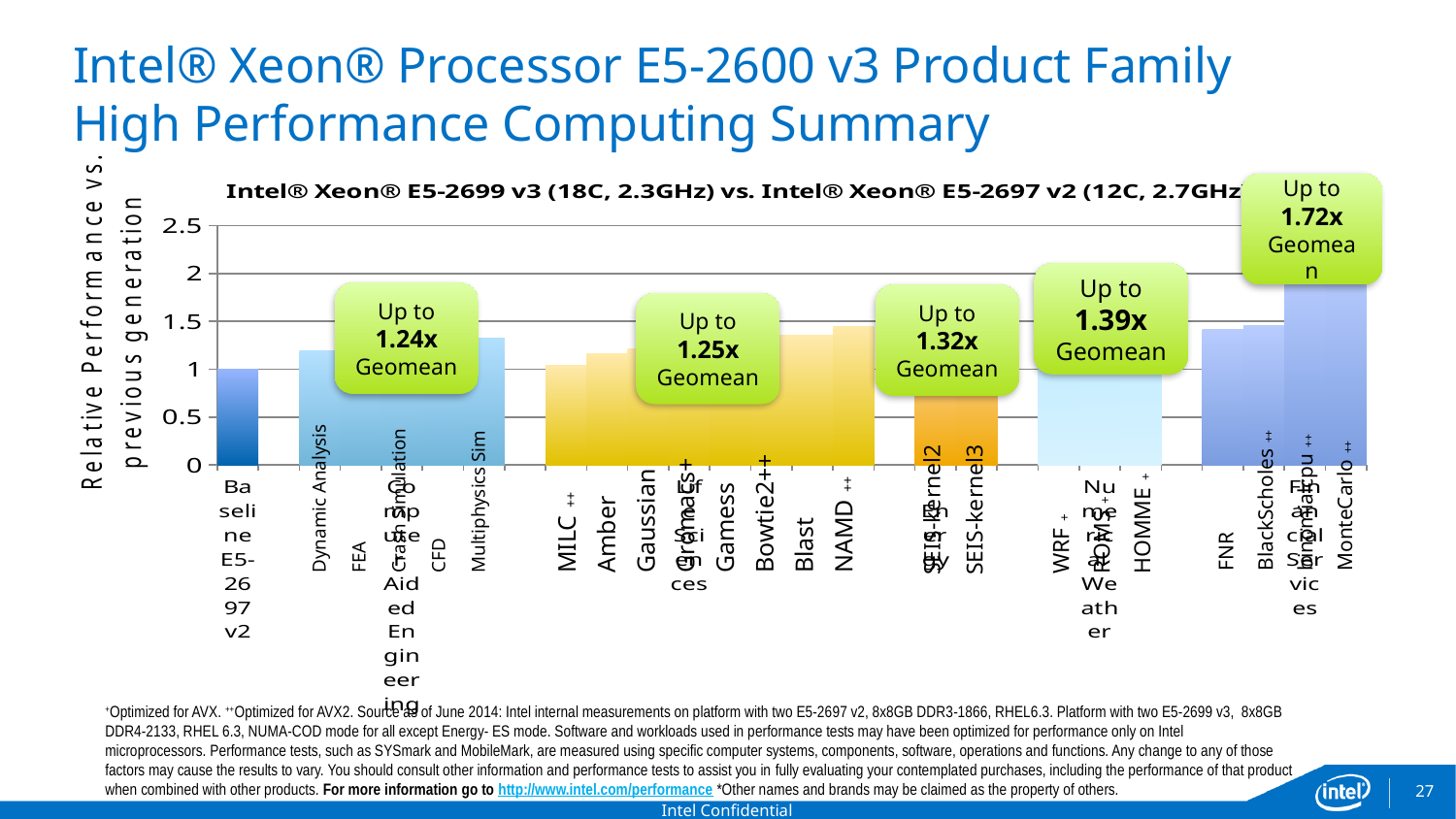
Is the value for MonteCarlo greater or less than 2? greater What geomean speed-up is shown in the callout for the Numerical Weather group? Up to 1.39x What geomean speed-up is shown in the callout for the Energy group? Up to 1.32x Which group has the larger geomean callout, Financial Services or Computer Aided Engineering? Financial Services What geomean speed-up is shown in the callout for the Financial Services group? Up to 1.72x How many 'Up to ... Geomean' callouts are shown on the chart? 5 What is the relative performance value for the Baseline E5-2697 v2 bar? 1 What kind of chart is shown on the slide? bar chart Is the value for Dynamic Analysis greater or less than 1.5? less Which workload has the highest relative performance bar? MonteCarlo What geomean speed-up is shown in the callout for the Life Sciences group? Up to 1.25x What geomean speed-up is shown in the callout for the Computer Aided Engineering group? Up to 1.24x